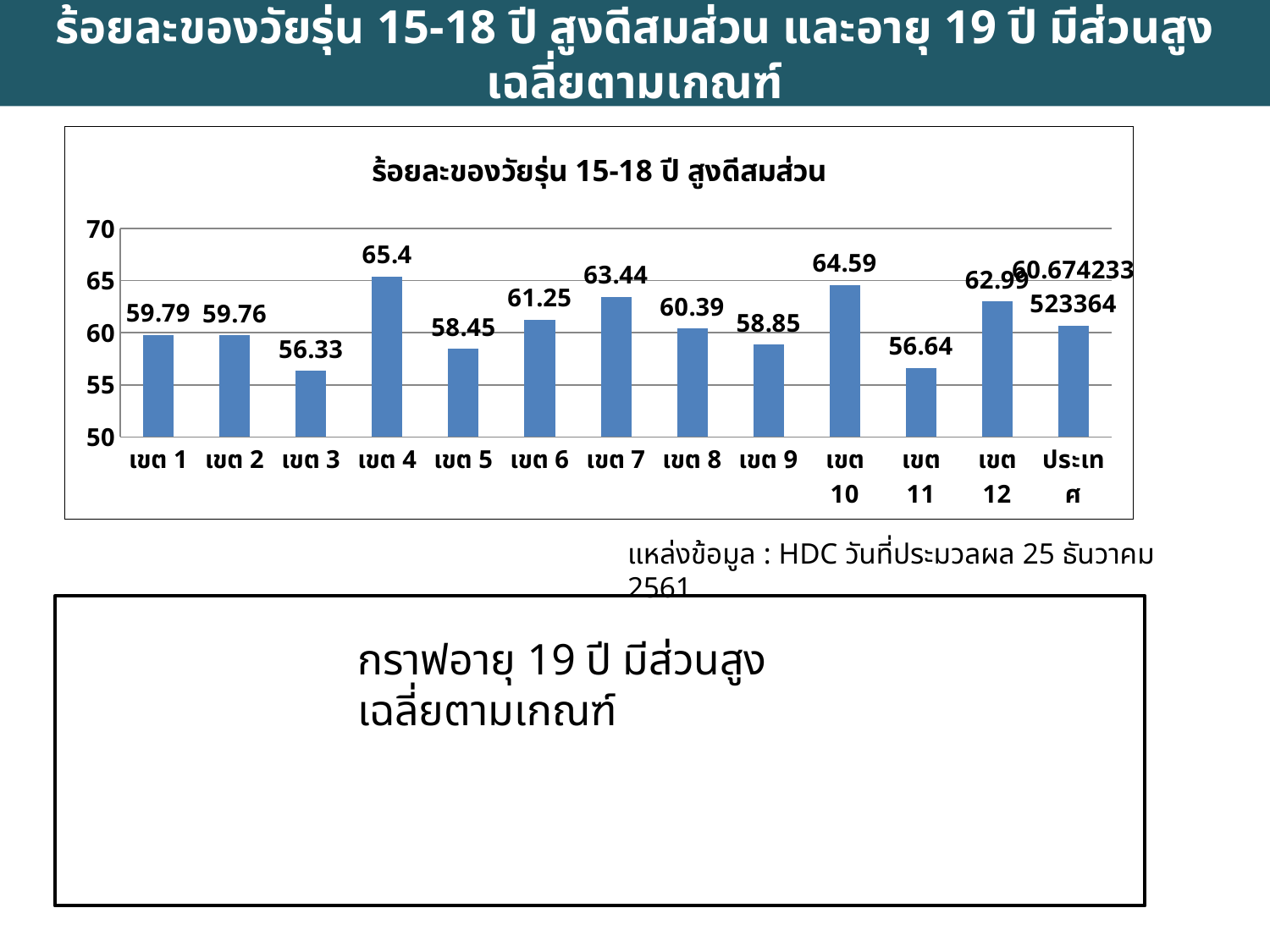
What is the value for เขต 7? 63.44 What is the difference between the values for เขต 4 and เขต 3? 9.07 Which is larger, the value for เขต 7 or the value for เขต 8? เขต 7 What is the value for เขต 3? 56.33 What is the value for เขต 4? 65.4 What type of chart is shown on the slide? bar chart How many categories are shown on the x axis? 13 Is the value for เขต 11 greater or less than 60? less What is the value for เขต 10? 64.59 Which category has the lowest value? เขต 3 Which category has the highest value? เขต 4 What is the difference between the values for เขต 10 and เขต 11? 7.95